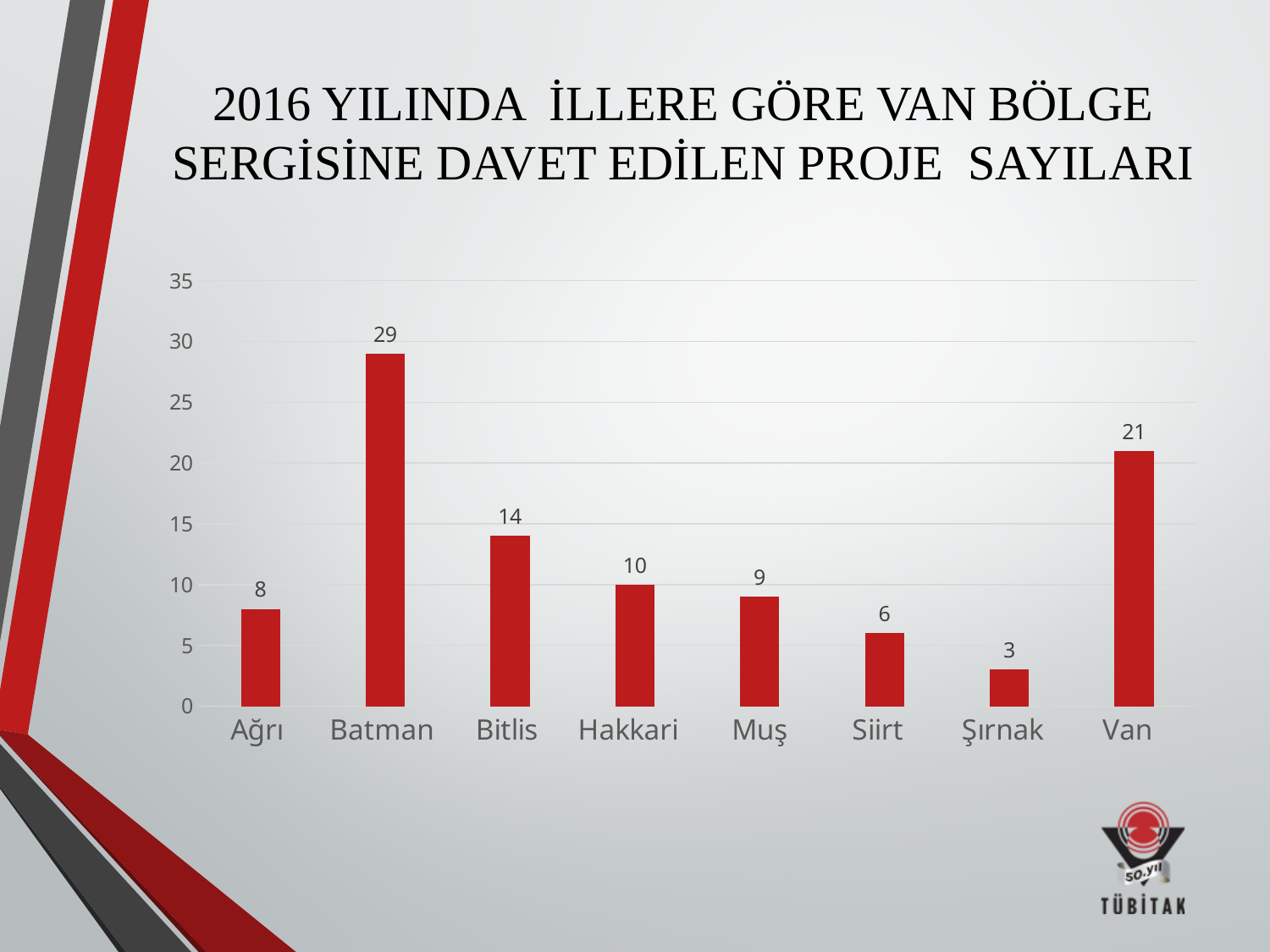
What kind of chart is shown on the slide? bar chart Which province has the highest value? Batman What colour are the bars in the chart? red Which province has the lowest value? Şırnak Is the value for Van greater or less than 20? greater What is the value for Batman? 29 What is the value for Hakkari? 10 What is the difference between the values for Bitlis and Siirt? 8 How many provinces are shown on the x axis? 8 Which is larger, the value for Ağrı or the value for Muş? Muş What is the difference between the values for Batman and Van? 8 What is the value for Şırnak? 3